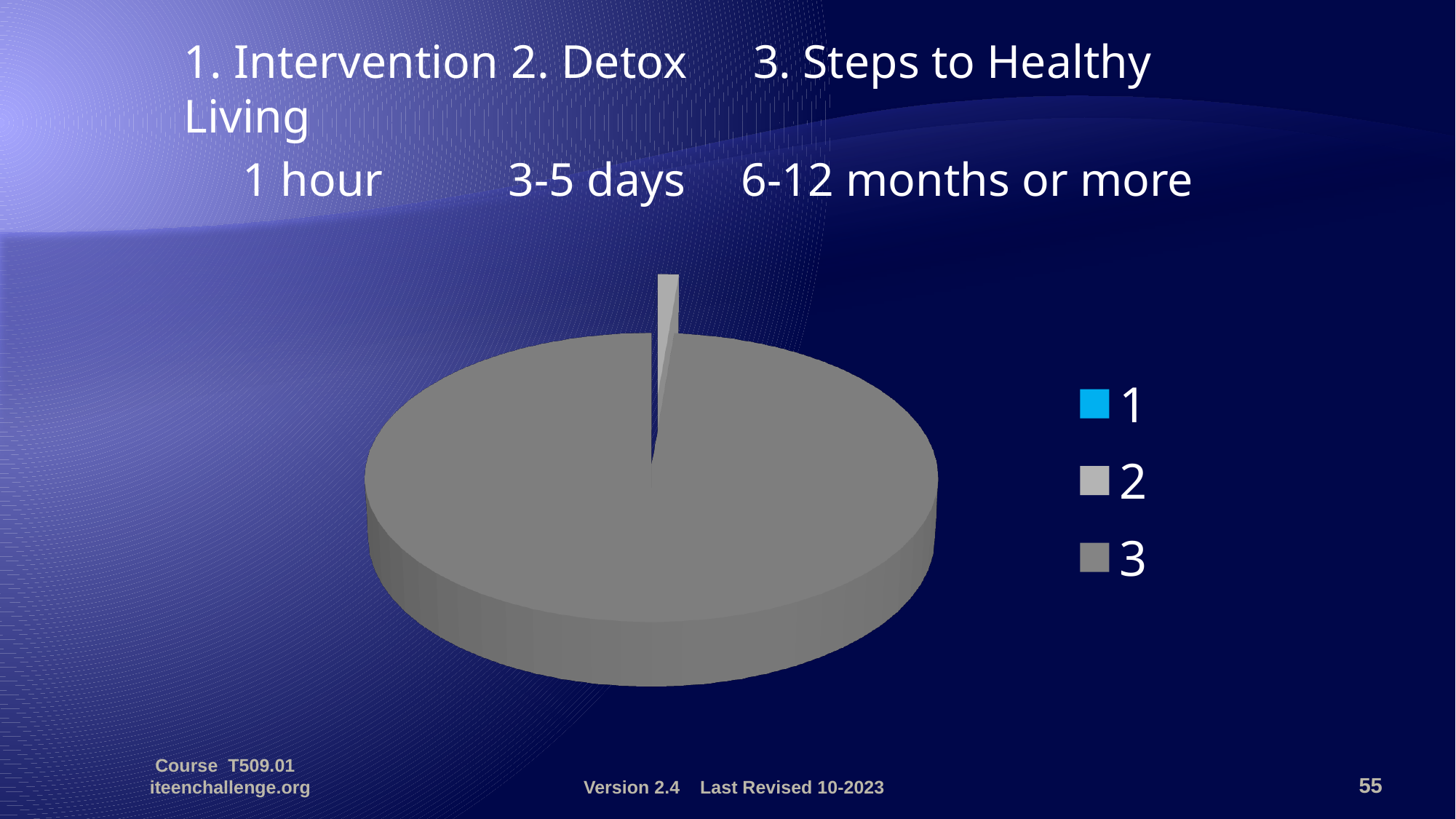
Does the slice for category 3 take up more or less than half of the pie chart? more According to the slide text, how long does stage 1, Intervention, last? 1 hour What colour is the legend marker for category 3? dark gray Which is larger in the pie chart, the slice for category 2 or the slice for category 3? 3 What kind of chart is shown on the slide? pie chart According to the slide text, how long does stage 3, Steps to Healthy Living, last? 6-12 months or more According to the slide text, how long does stage 2, Detox, last? 3-5 days What colour is the legend marker for category 1? blue How many entries does the legend of the pie chart list? 3 Which legend category takes up the largest share of the pie chart? 3